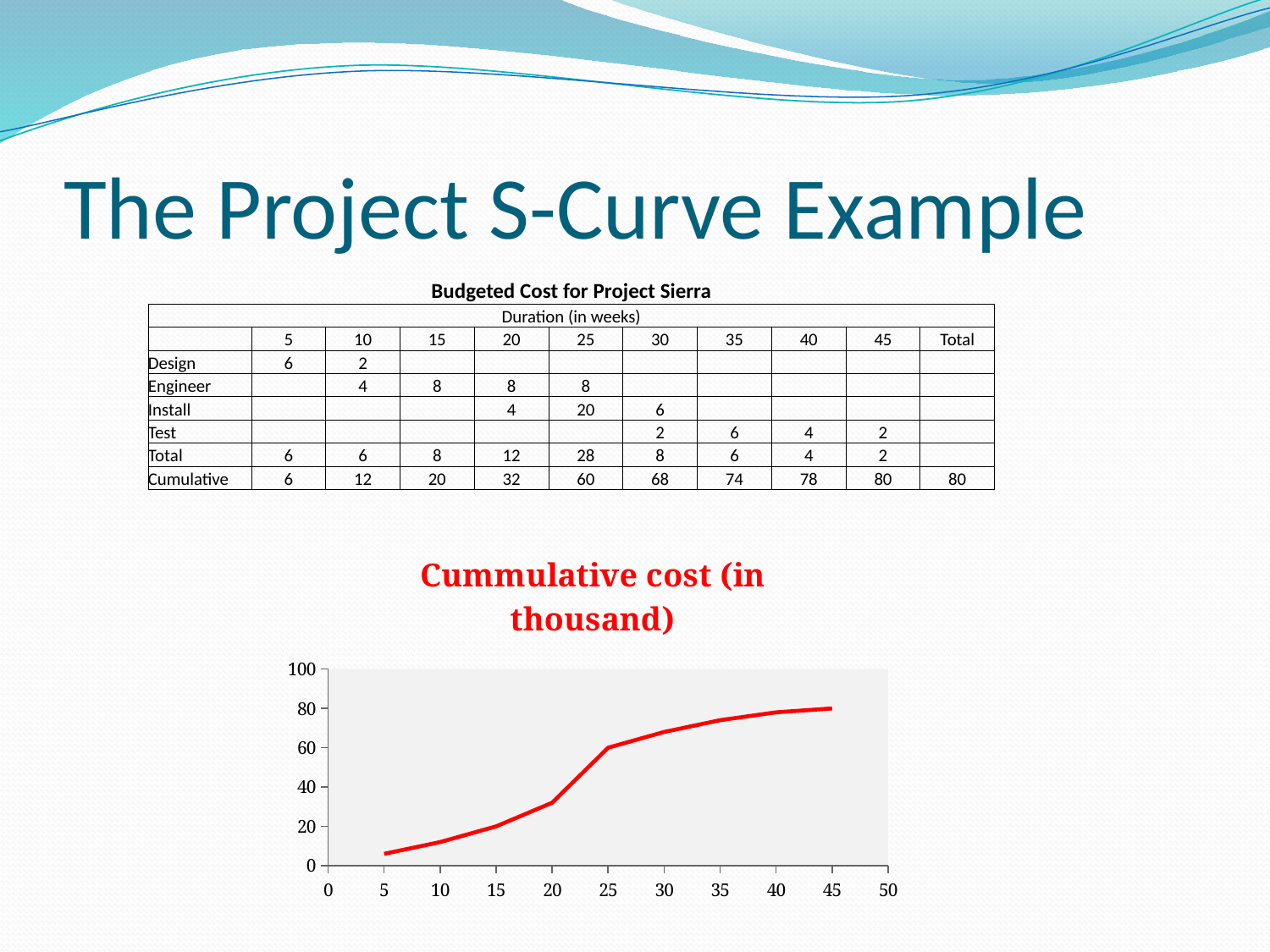
What is the difference between the cumulative cost at week 45 and at week 25? 20 What is the cumulative cost at week 45? 80 At which week is the cumulative cost highest? 45 What kind of chart is shown on the slide? line chart Is the cumulative cost at week 20 greater or less than 40? less What is the title of the chart? Cummulative cost (in thousand) Is the cumulative cost at week 30 greater or less than 60? greater What is the cumulative cost at week 25? 60 What is the cumulative cost at week 15? 20 What colour is the line in the chart? red Does the cumulative cost rise or fall as the weeks increase along the x axis? rise At which week is the cumulative cost lowest? 5